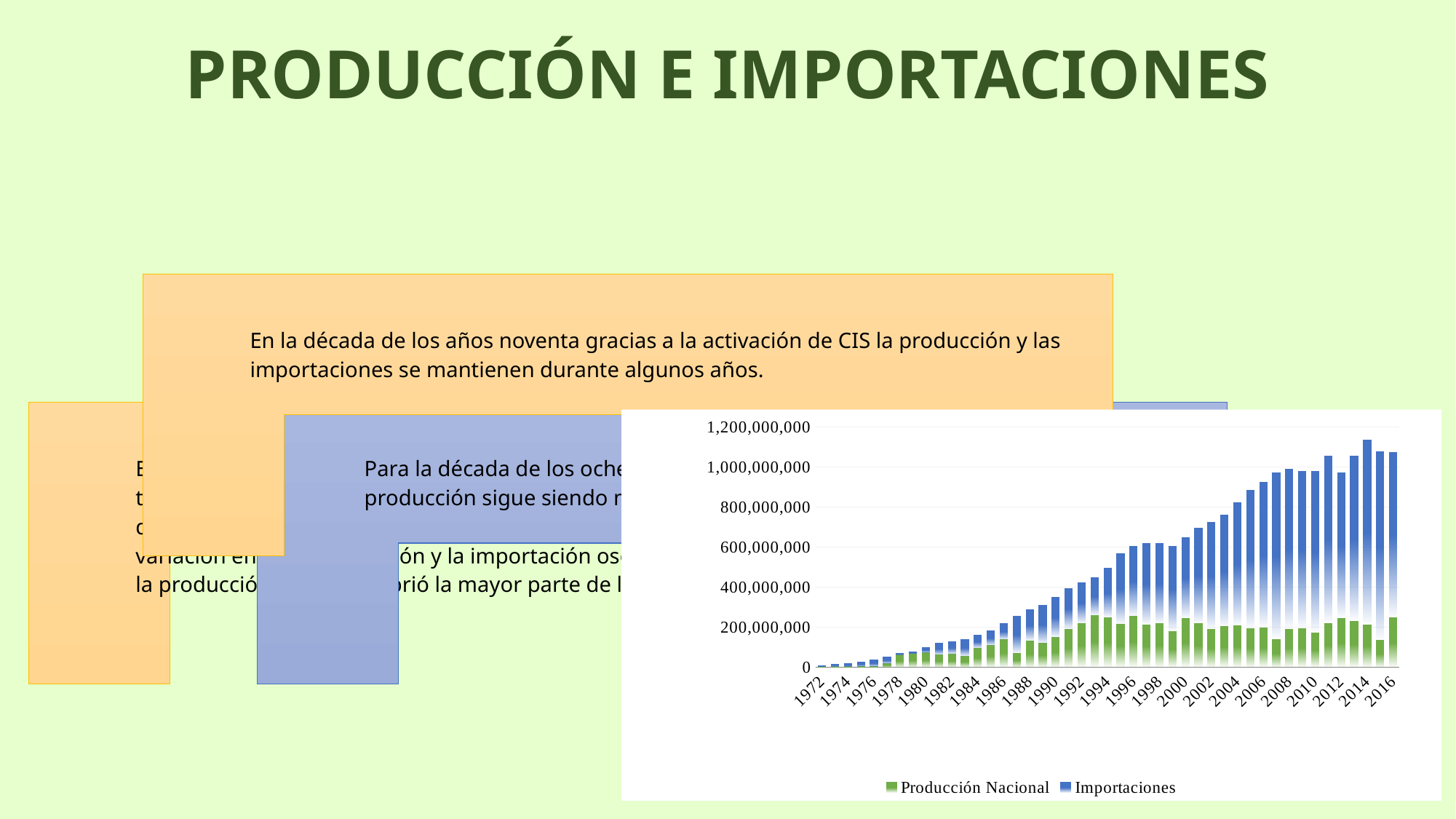
Which colour represents Importaciones in the chart? blue What kind of chart is shown on the slide? bar chart Is the Producción Nacional value for 2016 greater or less than 400,000,000? less In 2016, which is larger: Producción Nacional or Importaciones? Importaciones Is the Importaciones value for 1990 greater or less than 400,000,000? less What are the two series named in the chart legend? Producción Nacional and Importaciones Is the Importaciones value for 2014 greater or less than 1,000,000,000? less How many series does the chart legend list? 2 Do the Importaciones values generally rise or fall from 1972 to 2016? rise In which year is the Importaciones bar the shortest? 1972